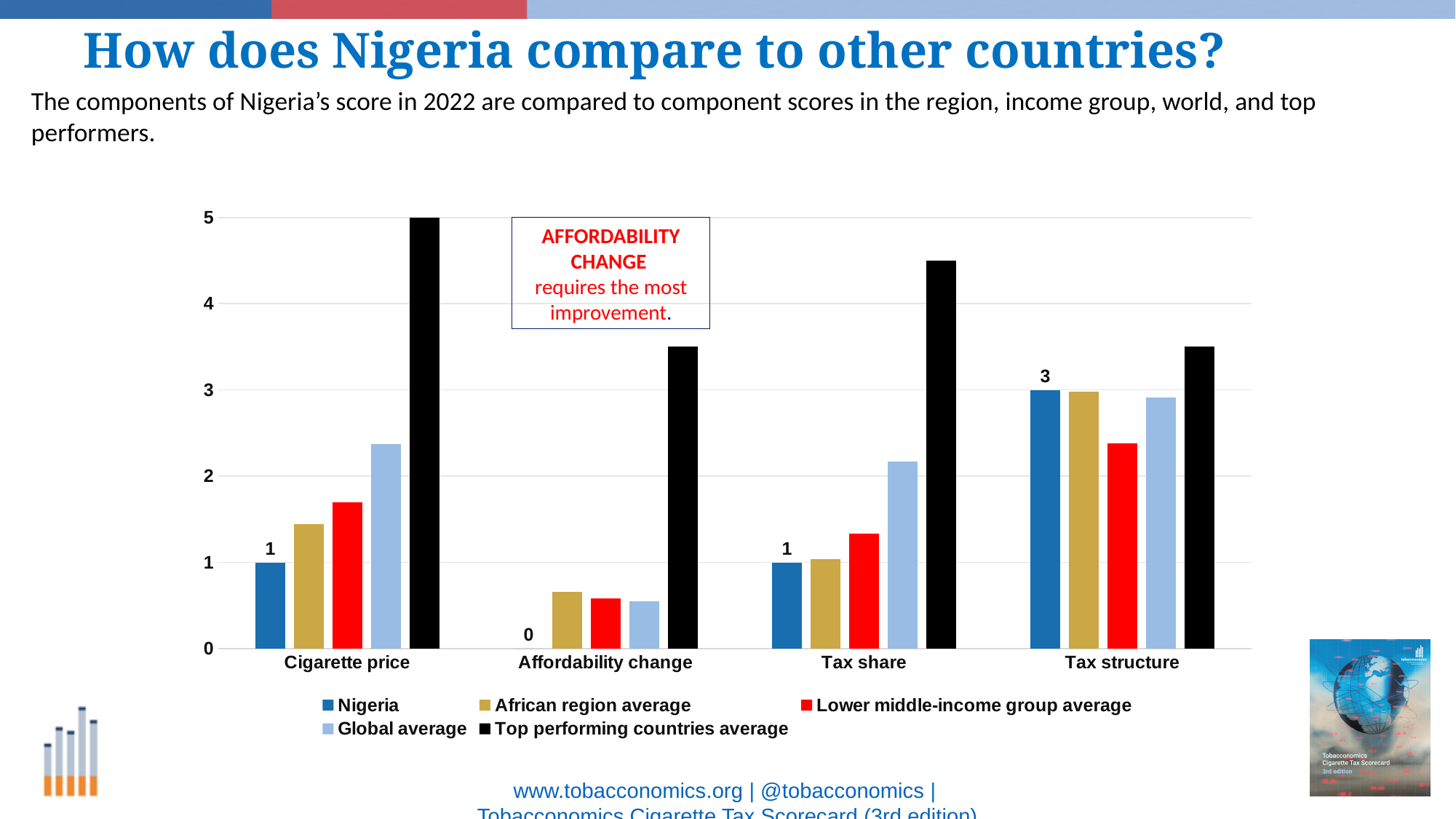
What is Nigeria's score for Affordability change? 0 What is Nigeria's score for Cigarette price? 1 What type of chart is shown on the slide? Bar chart Which is larger for Tax share: the Global average or Nigeria's score? Global average What is the difference between Nigeria's Tax structure score and its Cigarette price score? 2 How many series does the legend list? 5 In which component does Nigeria have its lowest score? Affordability change Is the Top performing countries average for Tax share greater or less than 4? greater Is the Global average for Cigarette price greater or less than 2? greater What is Nigeria's score for Tax structure? 3 What is the Top performing countries average for Cigarette price? 5 In which component does Nigeria have its highest score? Tax structure